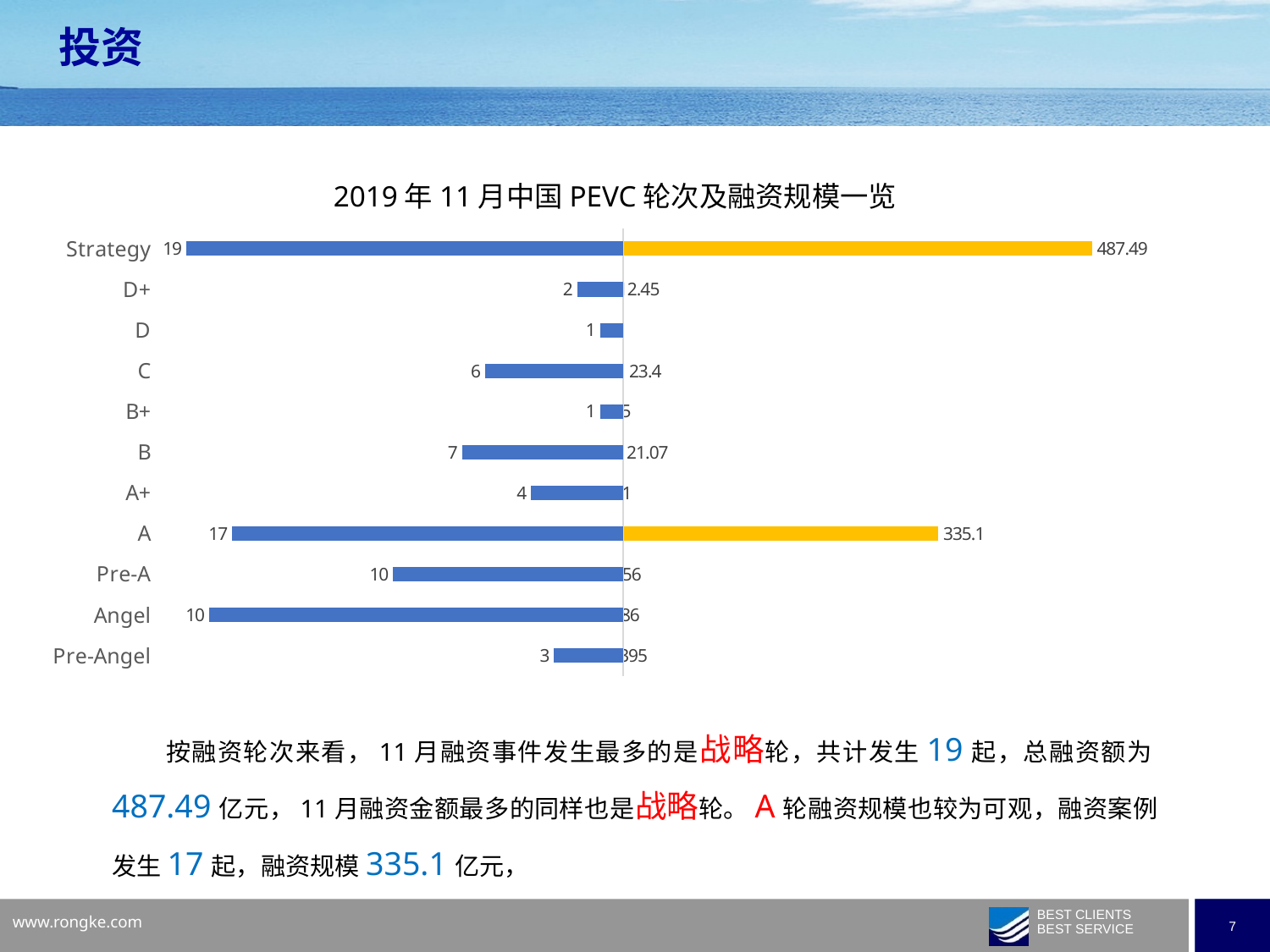
What kind of chart is shown on the slide? bar chart What is the financing amount (orange bar) for the B round? 21.07 Which round has the largest financing amount (orange bar)? Strategy What is the number of financing events (blue bar) for the A round? 17 How many funding rounds (categories) are listed on the chart? 11 What is the financing amount (orange bar) for the Strategy round? 487.49 What is the difference between the financing amounts of the Strategy round and the A round? 152.39 What is the financing amount (orange bar) for the A round? 335.1 Which round has the highest number of financing events (blue bar)? Strategy What is the title of the chart? 2019 年 11 月中国 PEVC 轮次及融资规模一览 What is the financing amount (orange bar) for the C round? 23.4 What is the number of financing events (blue bar) for the Strategy round? 19